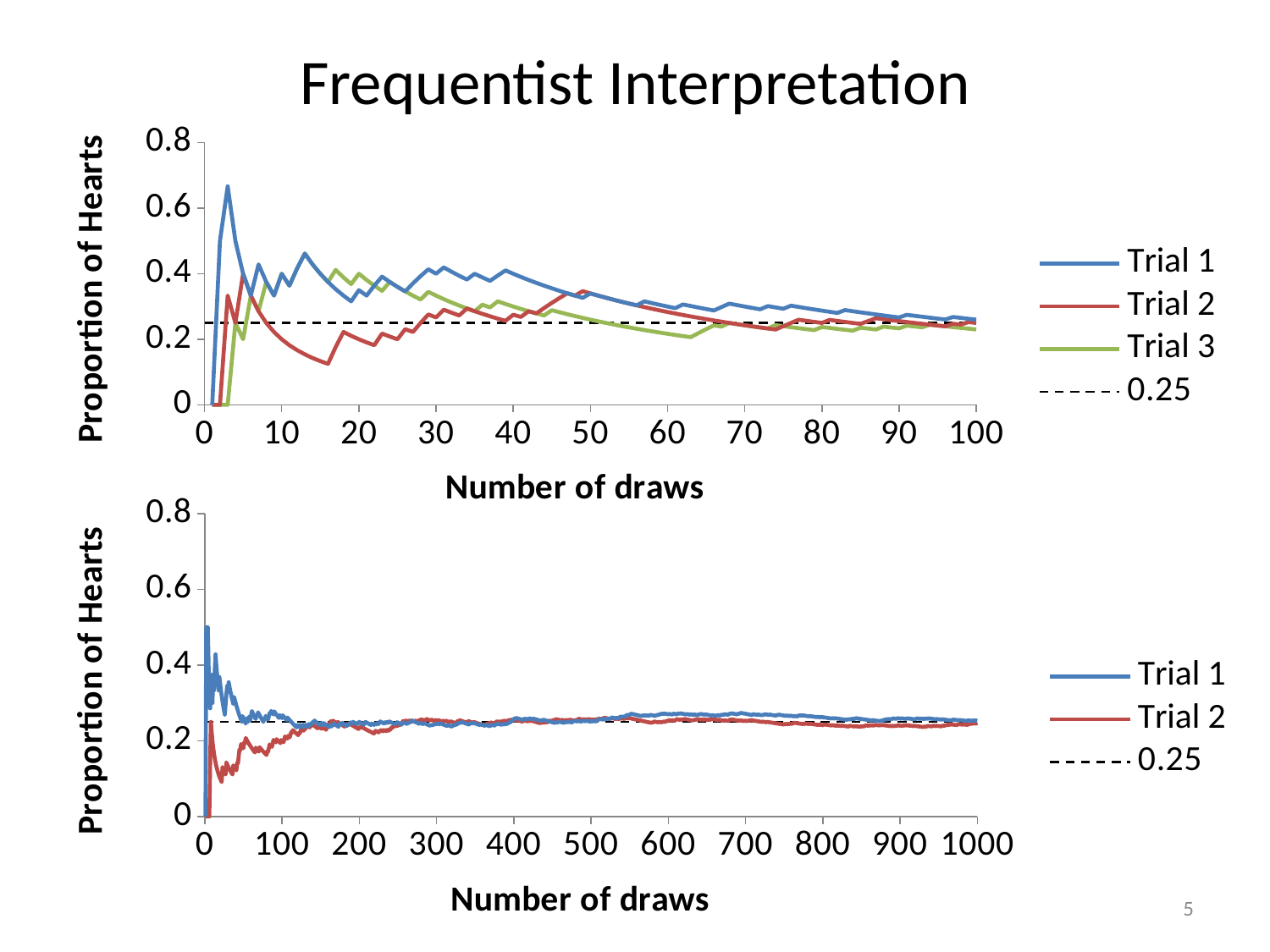
What kind of chart is the top chart on the slide? line chart In the top chart, which trial reaches the highest proportion of hearts? Trial 1 In the top chart, is the value of Trial 2 at around 15 draws greater or less than 0.2? less What is the title of the y axis on the top chart? Proportion of Hearts In the bottom chart, does Trial 2 rise or fall between 0 and 200 draws? rise In the bottom chart, which trial dips to the lowest proportion of hearts in the first 100 draws? Trial 2 How many entries does the legend of the top chart list? 4 How many entries does the legend of the bottom chart list? 3 In the top chart, at around 15 draws, which is larger: Trial 1 or Trial 2? Trial 1 In the top chart, what value does the dashed horizontal reference line represent? 0.25 In the top chart, is the peak value of Trial 1 near the start greater or less than 0.6? greater What is the largest value shown on the x axis of the bottom chart? 1000